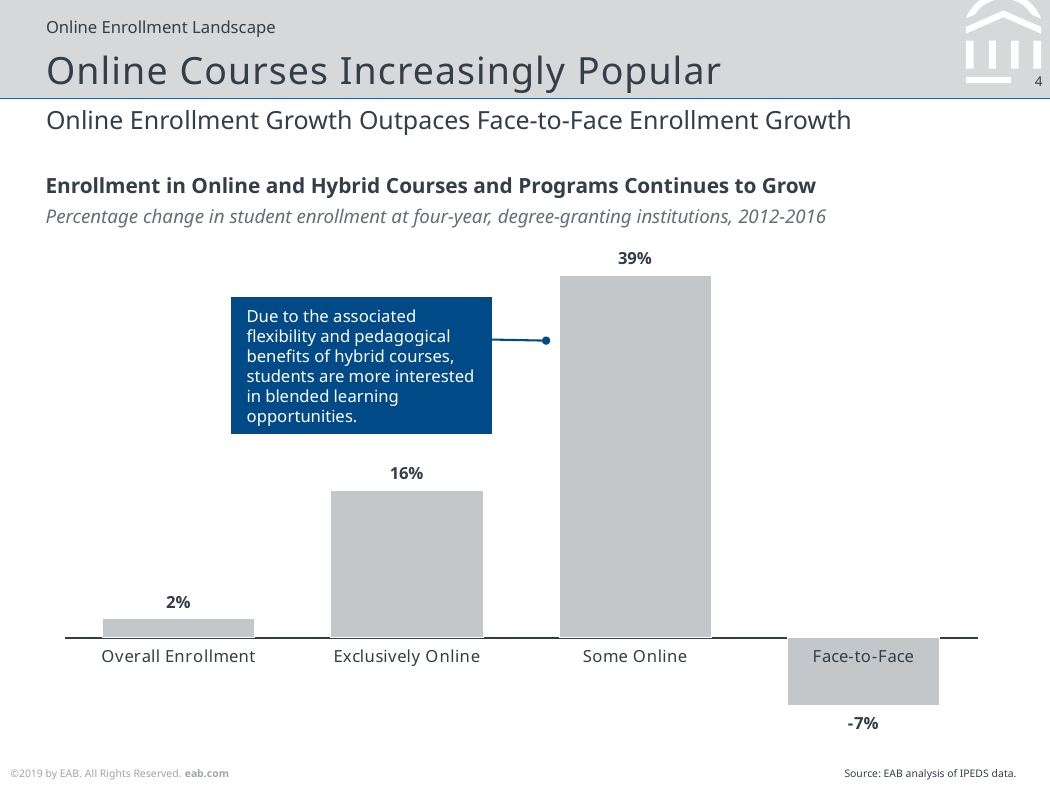
What is the percentage change for Overall Enrollment? 2% What kind of chart is shown on the slide? Bar chart What is the difference between the Some Online and Exclusively Online values? 23 percentage points How many categories are shown in the chart? 4 What time period does the chart's subtitle say the percentage change covers? 2012-2016 Which is larger, the value for Exclusively Online or the value for Overall Enrollment? Exclusively Online Which category has the lowest percentage change? Face-to-Face Which category has the highest percentage change? Some Online What is the percentage change in enrollment for Some Online? 39% What is the percentage change in enrollment for Face-to-Face? -7% What is the title of the chart? Enrollment in Online and Hybrid Courses and Programs Continues to Grow What is the percentage change in enrollment for Exclusively Online? 16%